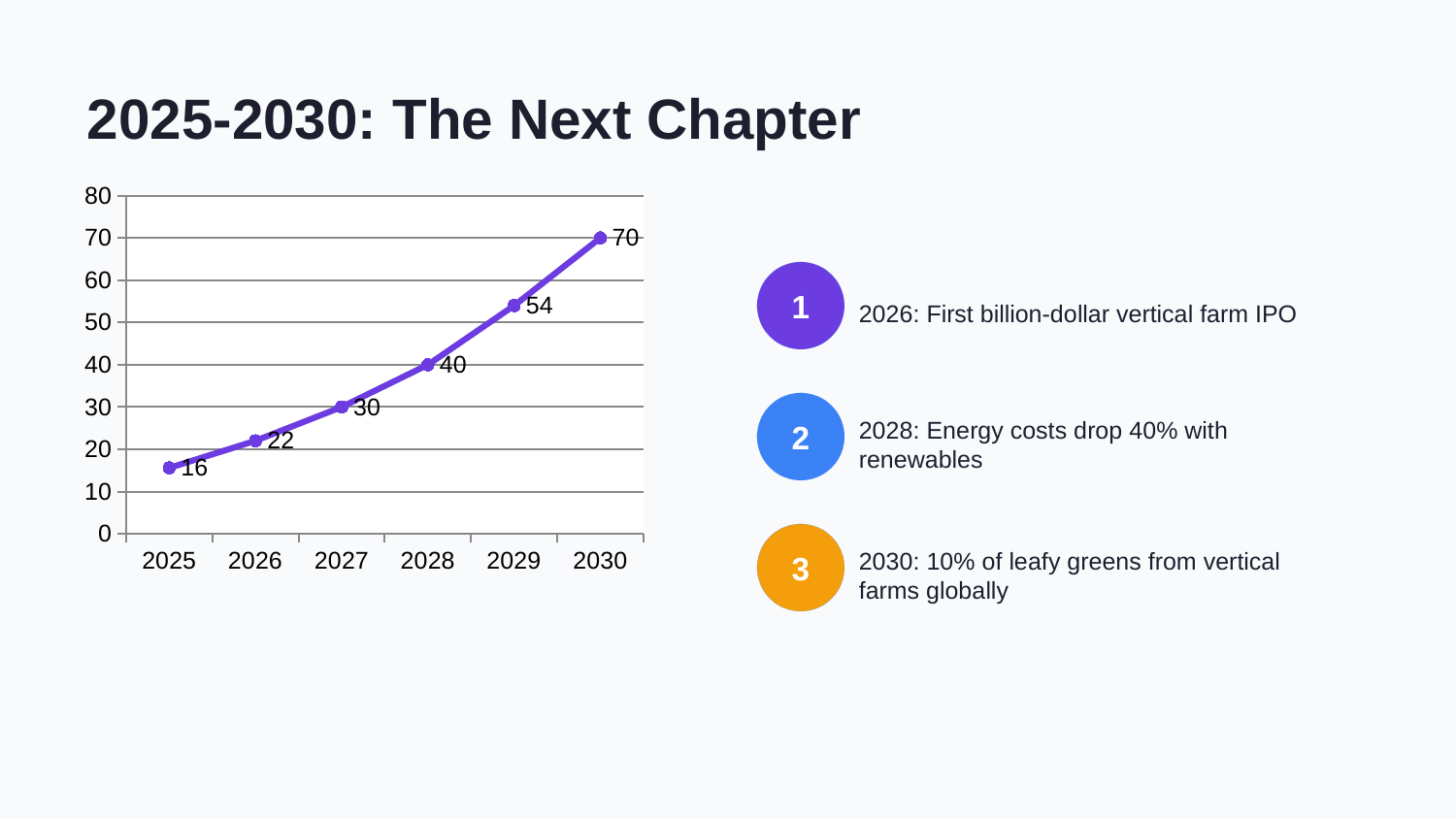
Which year has the highest value? 2030 What is the value for 2030? 70 Which is larger, the value for 2027 or the value for 2026? 2027 What is the difference between the values for 2030 and 2025? 54 Which year has the lowest value? 2025 What kind of chart is shown on the slide? line chart What is the difference between the values for 2029 and 2028? 14 Is the value for 2029 greater or less than 50? greater How many data points are plotted on the chart? 6 What is the value for 2025? 16 Do the values rise or fall from 2025 to 2030? rise What is the value for 2028? 40